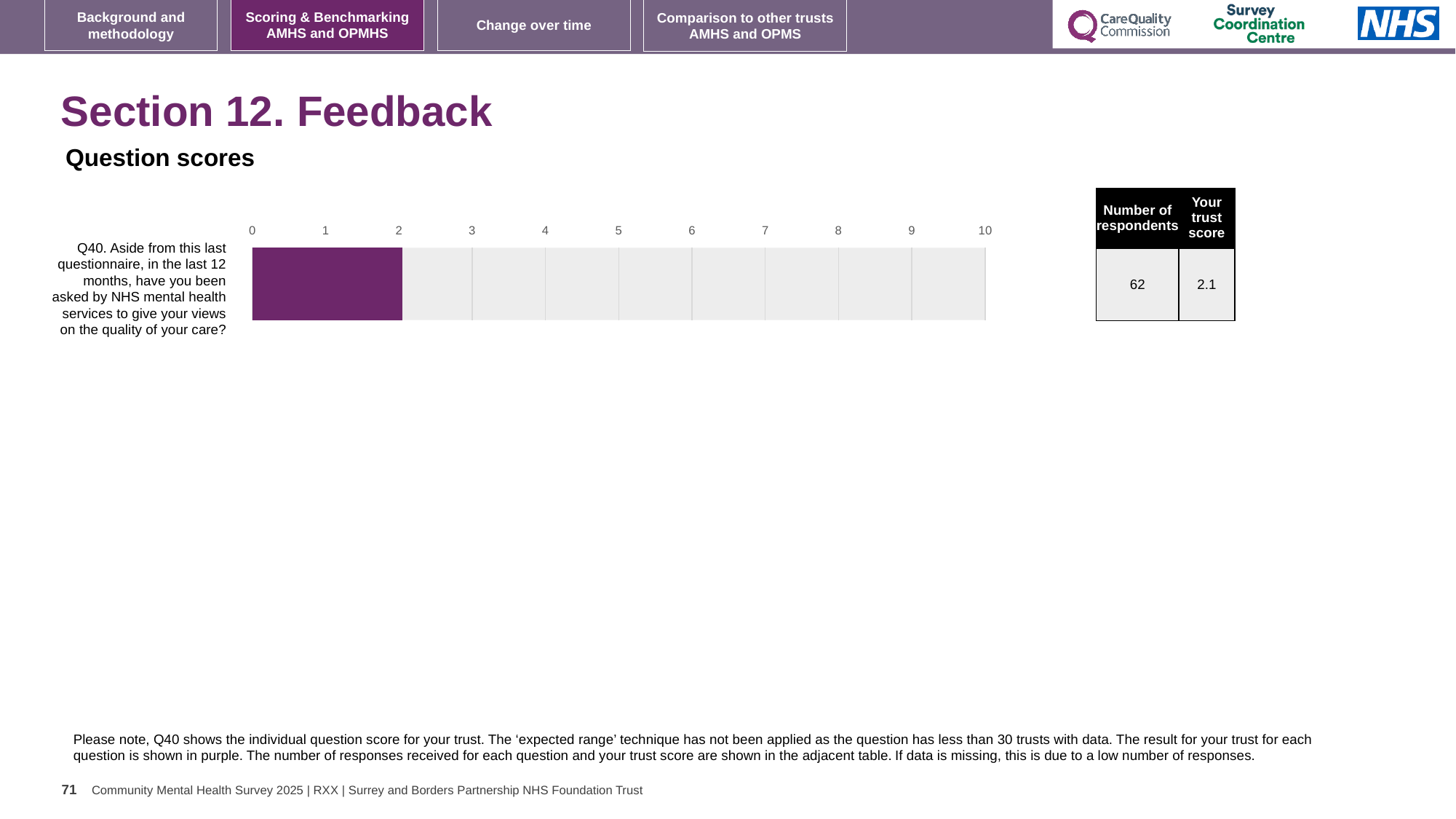
Is the value of the bar for Q40 greater or less than 5? less How many respondents answered Q40 according to the table next to the chart? 62 What is the trust score for Q40 shown in the adjacent table? 2.1 How many questions (categories) are plotted in the chart? 1 Is the value of the bar for Q40 greater or less than 1? greater What is the maximum value shown on the chart's horizontal axis? 10 Is the value of the bar for Q40 greater or less than 3? less What kind of chart is shown on the slide? bar chart What colour is the bar showing the trust's result for Q40? purple